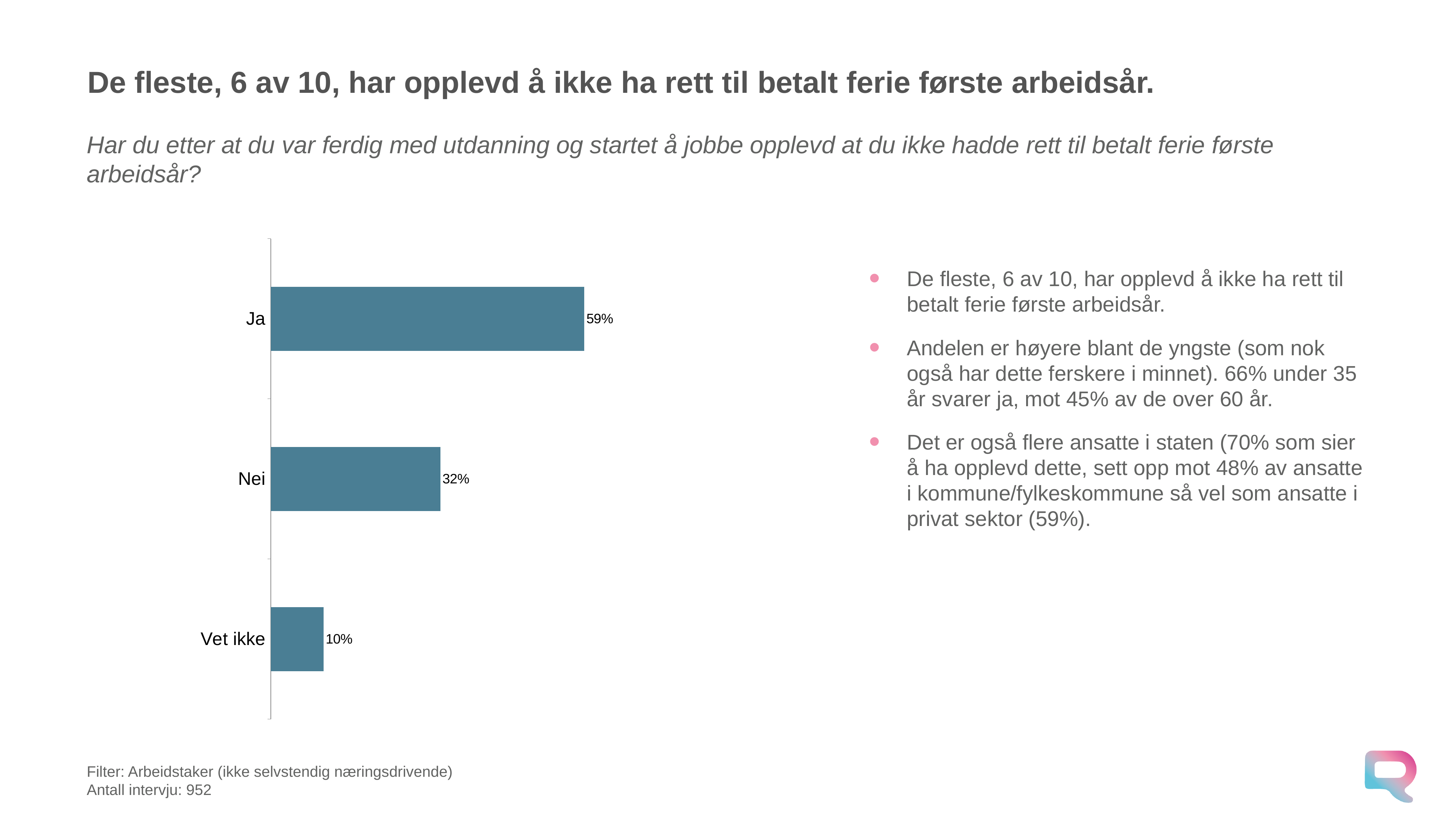
What is the total of the three values shown in the chart? 101% Which is larger, the value for Nei or the value for Vet ikke? Nei What is the value for Vet ikke? 10% Which category has the lowest value? Vet ikke How many categories are shown in the chart? 3 What kind of chart is shown on the slide? Bar chart What is the number of interviews (Antall intervju) stated below the chart? 952 What is the value for Ja? 59% What is the value for Nei? 32% What is the difference between the values for Ja and Nei? 27% What is the difference between the values for Nei and Vet ikke? 22% Which category has the highest value? Ja